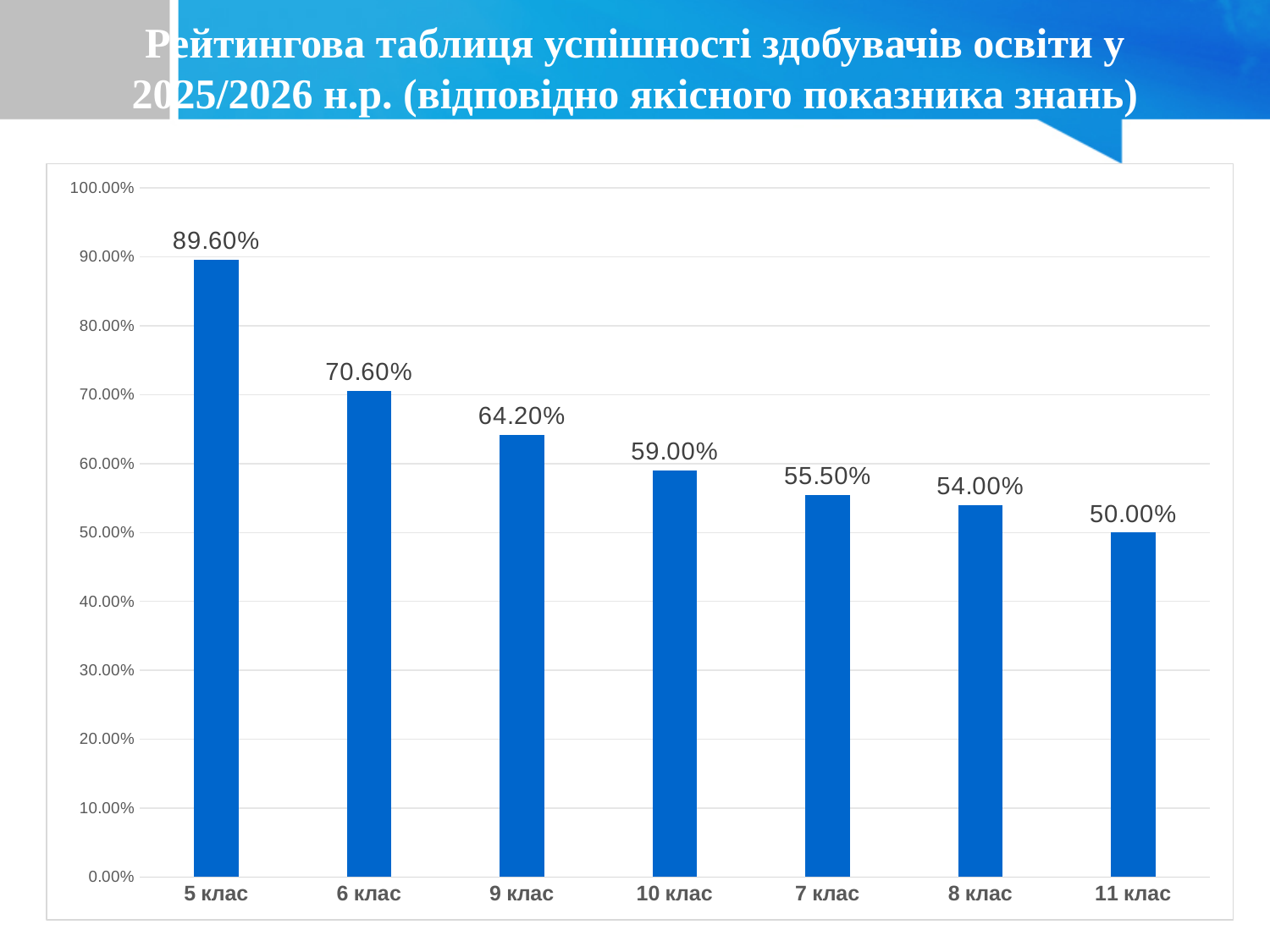
Is the value for 10 клас greater or less than 60.00%? less How many classes are shown on the x axis? 7 What is the difference between the values for 5 клас and 6 клас? 19.00% What kind of chart is shown on the slide? bar chart What is the difference between the values for 10 клас and 7 клас? 3.50% What is the value for 5 клас? 89.60% Which is larger, the value for 6 клас or the value for 9 клас? 6 клас What is the value for 9 клас? 64.20% Which class has the lowest value? 11 клас Which class has the highest value? 5 клас Do the values rise or fall from left to right along the x axis? fall What is the value for 8 клас? 54.00%